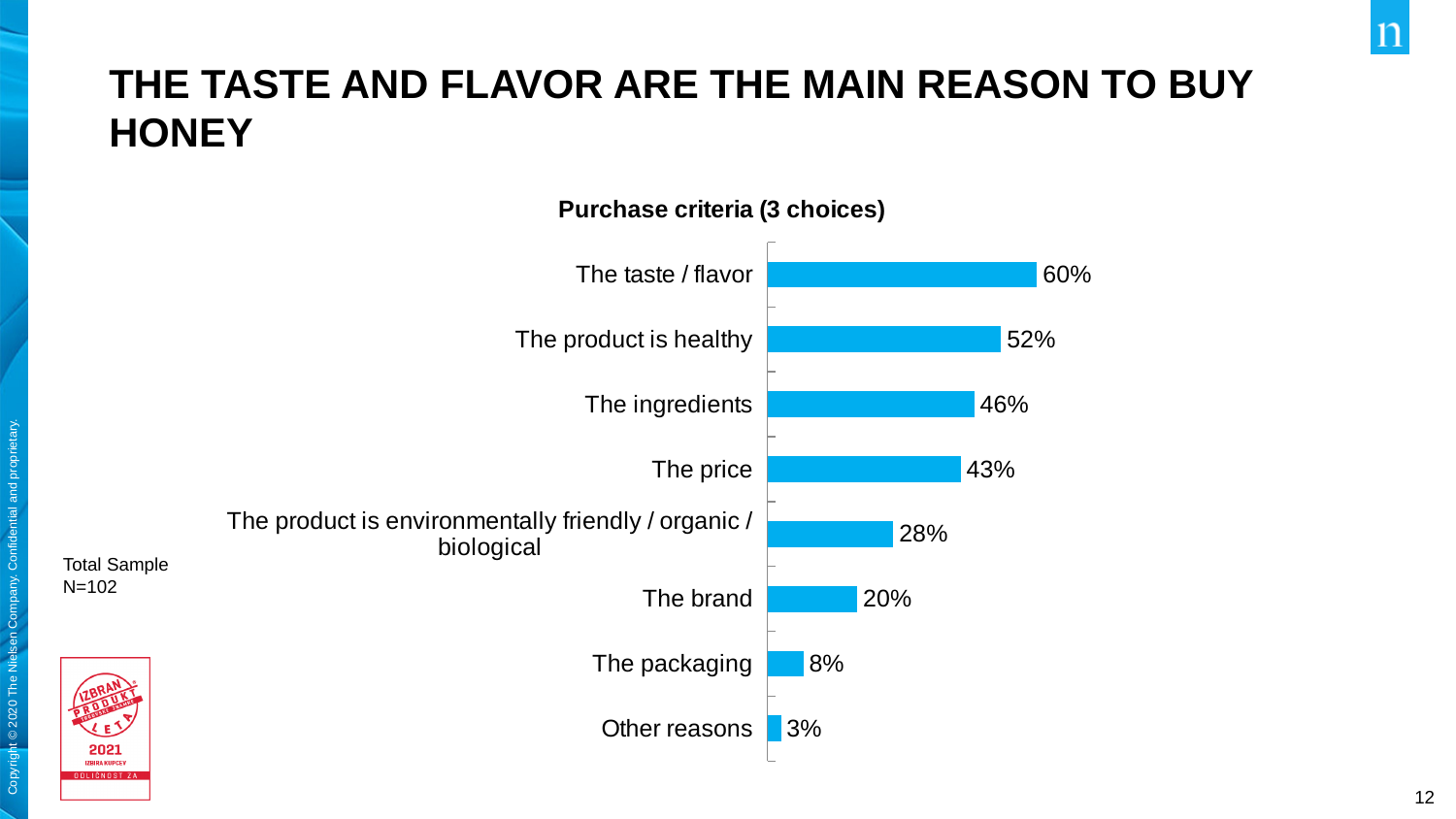
How many purchase criteria are shown in the chart? 8 What is the title of the chart? Purchase criteria (3 choices) Which has a larger value, 'The ingredients' or 'The price'? The ingredients What kind of chart is shown on the slide? Bar chart What is the sample size (N) stated on the slide? N=102 What percentage of respondents chose 'The taste / flavor' as a purchase criterion? 60% What is the value shown for 'The product is environmentally friendly / organic / biological'? 28% What is the value shown for 'The price'? 43% What is the difference between the values for 'The taste / flavor' and 'The product is healthy'? 8% Which purchase criterion has the highest value? The taste / flavor What is the difference between the values for 'The brand' and 'The packaging'? 12% Which purchase criterion has the lowest value? Other reasons